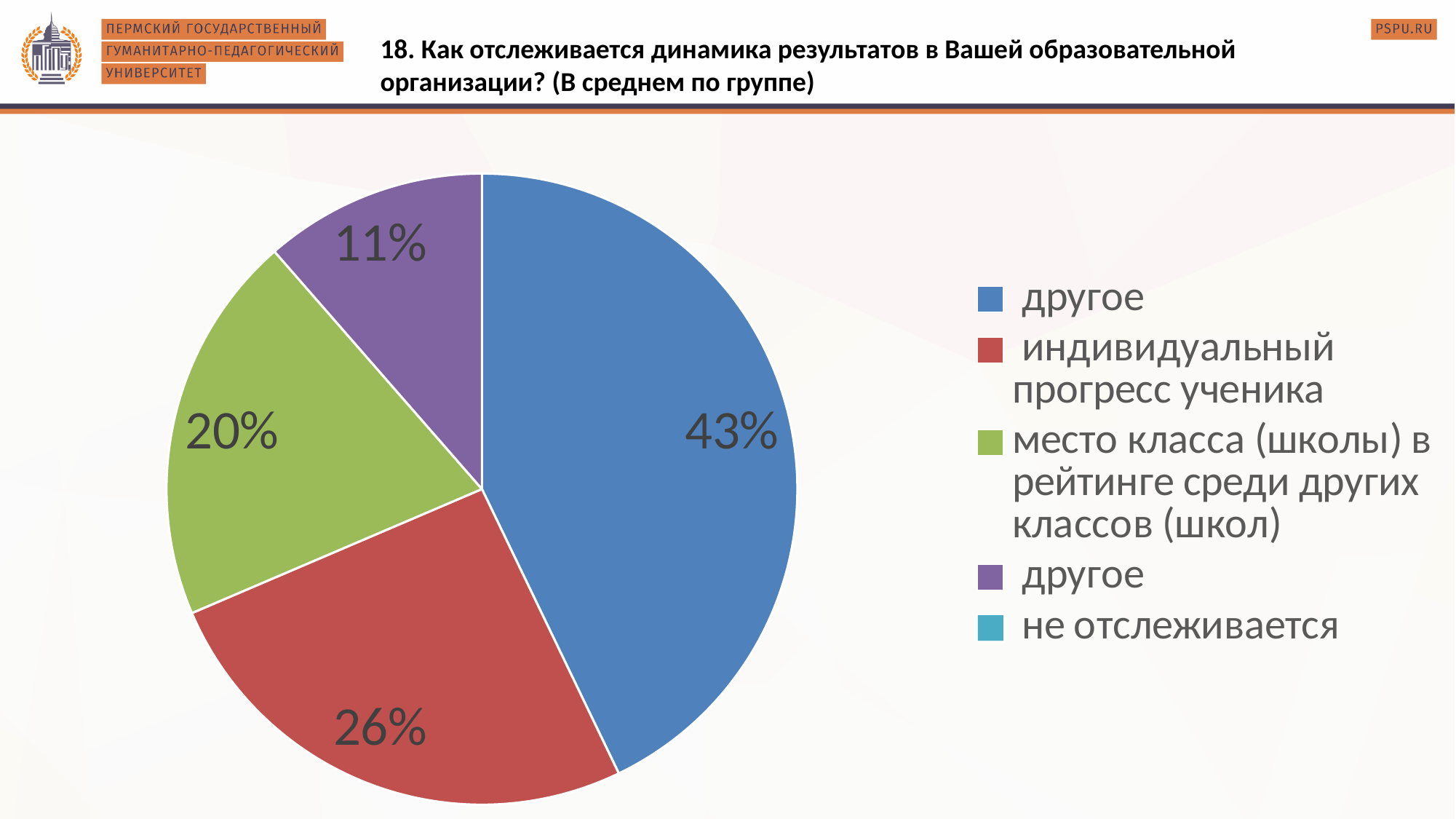
Which labelled slice of the pie is the smallest? the purple slice (другое), 11% Which slice of the pie is the largest? the blue slice (другое), 43% What kind of chart is shown on the slide? pie chart What percentage is shown on the purple slice of the pie? 11% How many slices with percentage labels are visible in the pie? 4 How many percentage points larger is the blue slice (43%) than "индивидуальный прогресс ученика"? 17 Which is larger: "индивидуальный прогресс ученика" or "место класса (школы) в рейтинге среди других классов (школ)"? индивидуальный прогресс ученика What percentage is shown for "индивидуальный прогресс ученика"? 26% What colour represents "индивидуальный прогресс ученика" in the legend? red How many entries does the legend list? 5 What percentage is shown on the blue slice of the pie? 43% What percentage is shown for "место класса (школы) в рейтинге среди других классов (школ)"? 20%